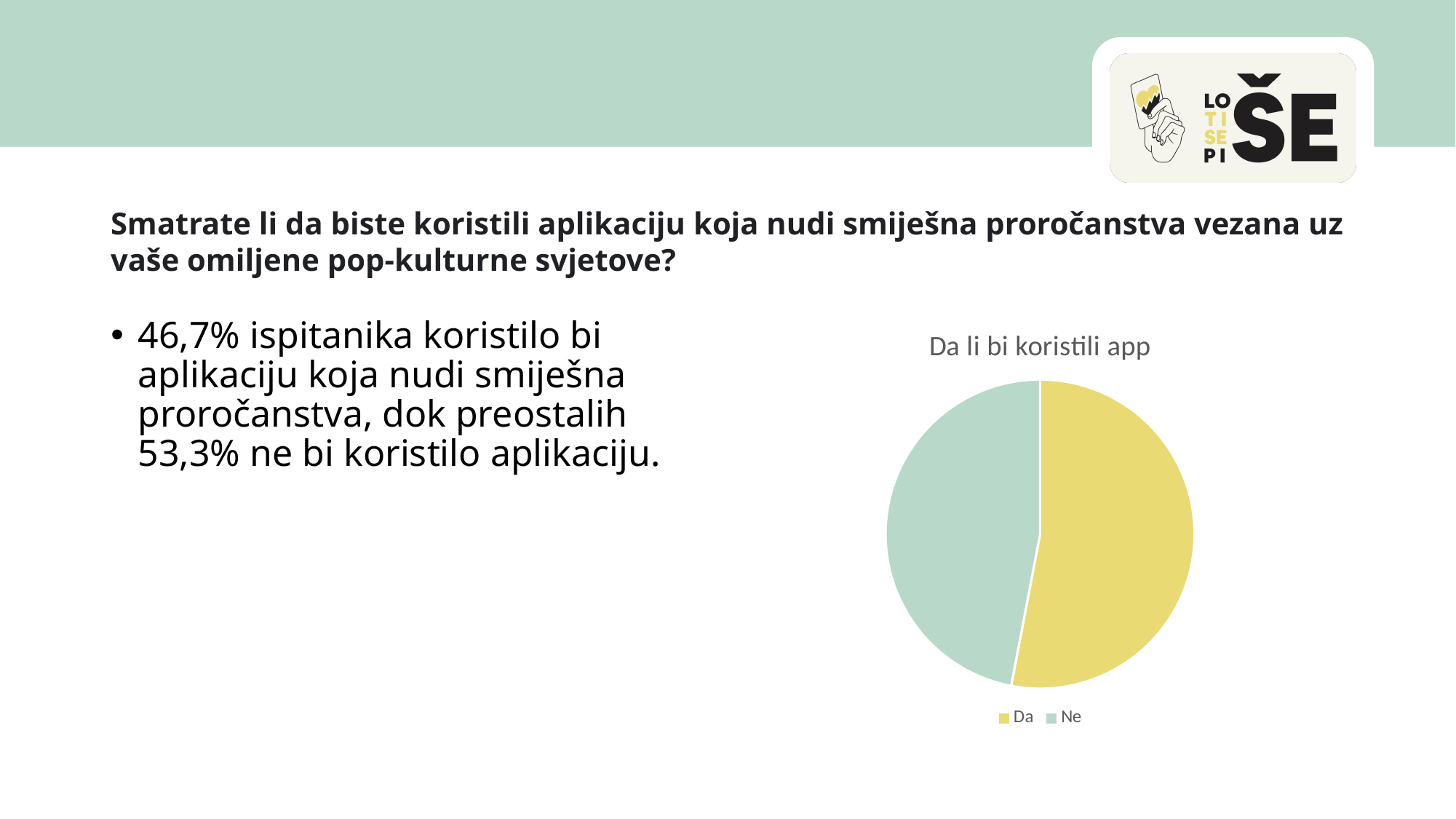
Which slice is larger in the pie chart, Da or Ne? Da Which slice of the pie chart is the smallest? Ne How many slices does the pie chart have? 2 What colour is the Da slice in the pie chart? yellow Which slice of the pie chart is the largest? Da What is the title of the pie chart? Da li bi koristili app What kind of chart is shown on the slide? pie chart How many entries does the legend of the pie chart list? 2